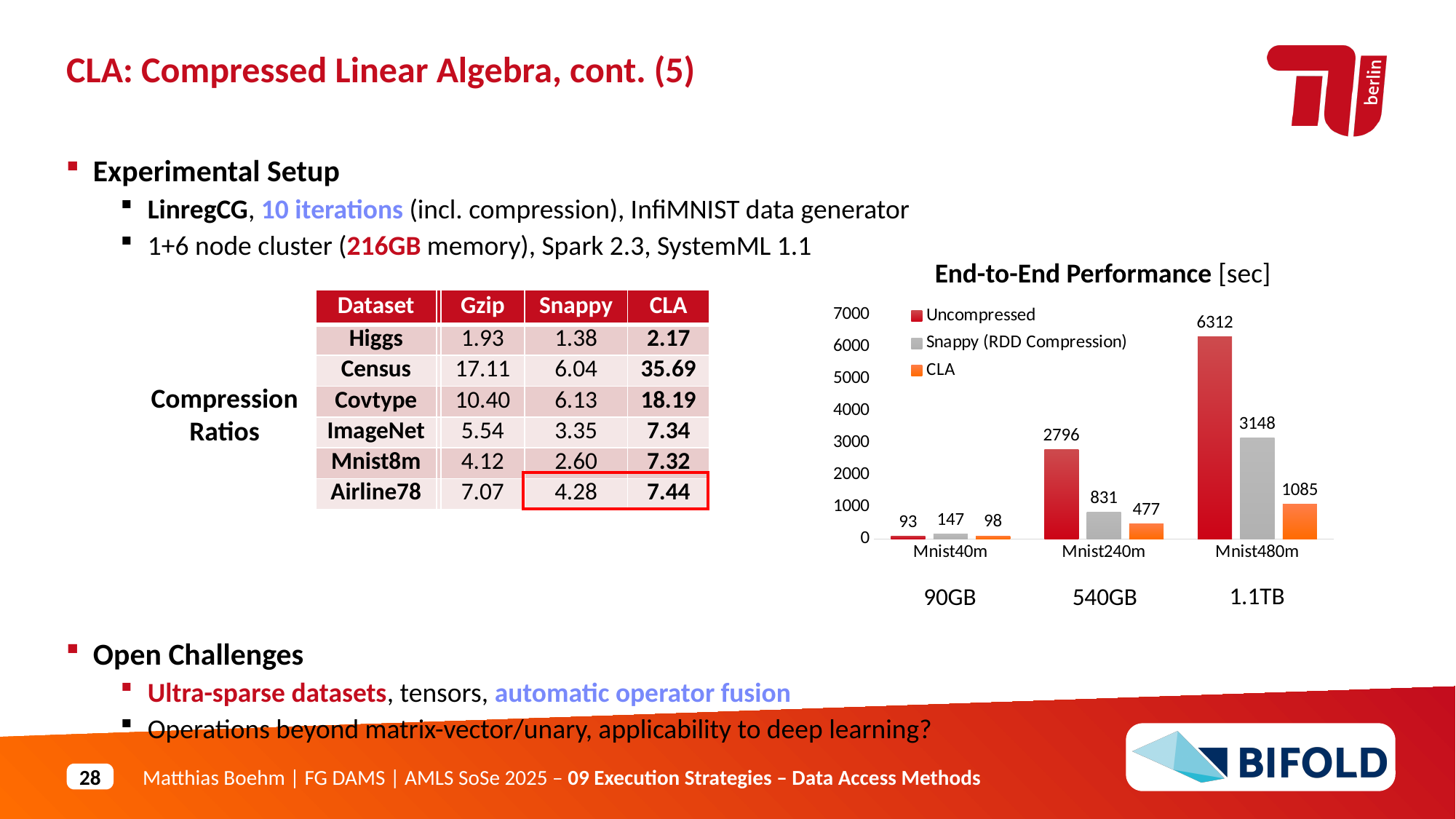
What kind of chart is the End-to-End Performance chart? bar chart In the End-to-End Performance chart, what is the difference between the Uncompressed and CLA values for Mnist480m? 5227 In the End-to-End Performance chart, what is the Snappy (RDD Compression) value for Mnist40m? 147 In the End-to-End Performance chart, how many series does the legend list? 3 In the End-to-End Performance chart, how many datasets are shown on the x axis? 3 In the End-to-End Performance chart, what is the difference between the Snappy (RDD Compression) and CLA values for Mnist240m? 354 In the End-to-End Performance chart, do the Uncompressed values rise or fall from Mnist40m to Mnist480m? rise In the End-to-End Performance chart, what is the Uncompressed value for Mnist480m? 6312 In the End-to-End Performance chart, which dataset has the highest Uncompressed value? Mnist480m In the End-to-End Performance chart, what is the CLA value for Mnist240m? 477 In the End-to-End Performance chart, which is larger for Mnist40m: the Uncompressed value or the Snappy (RDD Compression) value? Snappy (RDD Compression) In the End-to-End Performance chart, which series has the lowest value for Mnist480m? CLA